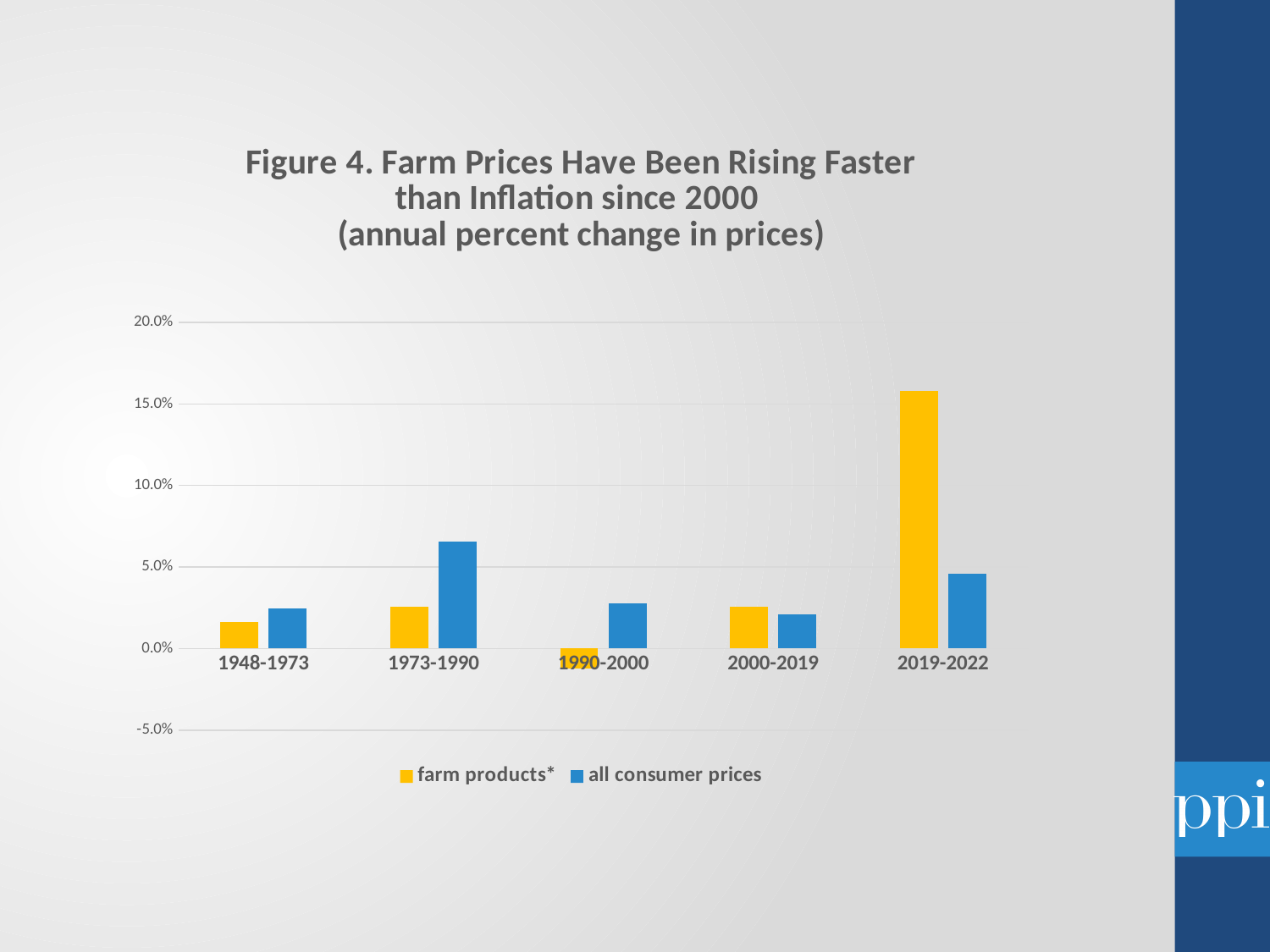
What colour represents farm products* in the chart? yellow In which period is the farm products* value highest? 2019-2022 What kind of chart is shown on the slide? bar chart How many series does the legend list? 2 How many time periods are shown on the x axis? 5 For 1973-1990, which is larger: farm products* or all consumer prices? all consumer prices In which period is the farm products* value lowest? 1990-2000 Is the farm products* value for 2019-2022 greater or less than 15.0%? greater Is the all consumer prices value for 2019-2022 greater or less than 5.0%? less In which period is the all consumer prices value highest? 1973-1990 Is the all consumer prices value for 1973-1990 greater or less than 5.0%? greater For 2019-2022, which is larger: farm products* or all consumer prices? farm products*